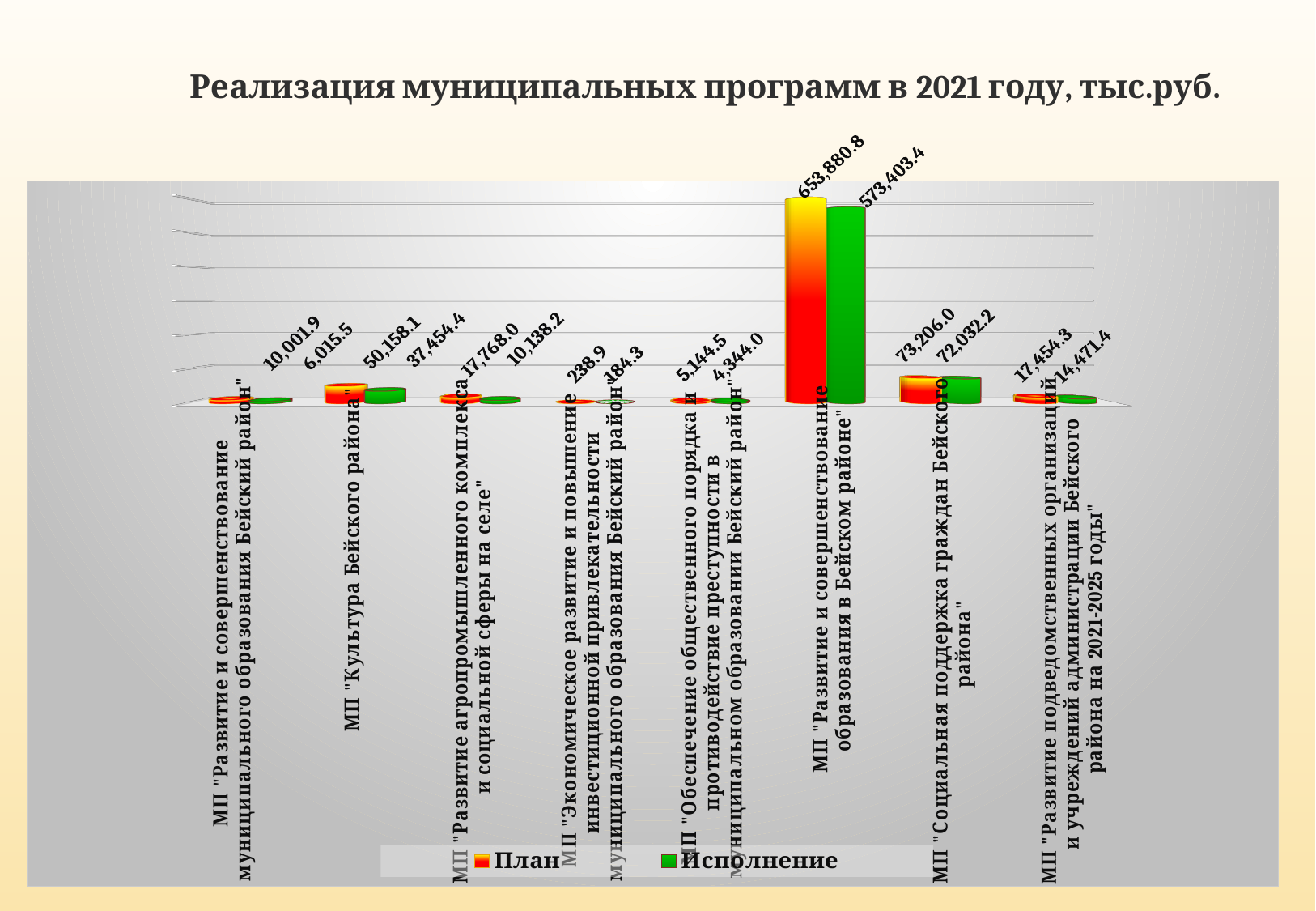
Which programme has the highest План value? МП "Развитие и совершенствование образования в Бейском районе" How many programmes (categories) are shown on the chart? 8 What is the difference between План and Исполнение for МП "Культура Бейского района"? 12,703.7 Which is larger: the Исполнение value for МП "Культура Бейского района" or the Исполнение value for МП "Социальная поддержка граждан Бейского района"? МП "Социальная поддержка граждан Бейского района" Which programme has the lowest Исполнение value? МП "Экономическое развитие и повышение инвестиционной привлекательности муниципального образования Бейский район" What is the Исполнение value for МП "Социальная поддержка граждан Бейского района"? 72,032.2 What is the План value for МП "Обеспечение общественного порядка и противодействие преступности в муниципальном образовании Бейский район"? 5,144.5 What is the План value for МП "Культура Бейского района"? 50,158.1 What is the Исполнение value for МП "Развитие и совершенствование образования в Бейском районе"? 573,403.4 How many series does the legend list? 2 What type of chart is shown on the slide? Bar chart What is the difference between План and Исполнение for МП "Развитие и совершенствование образования в Бейском районе"? 80,477.4